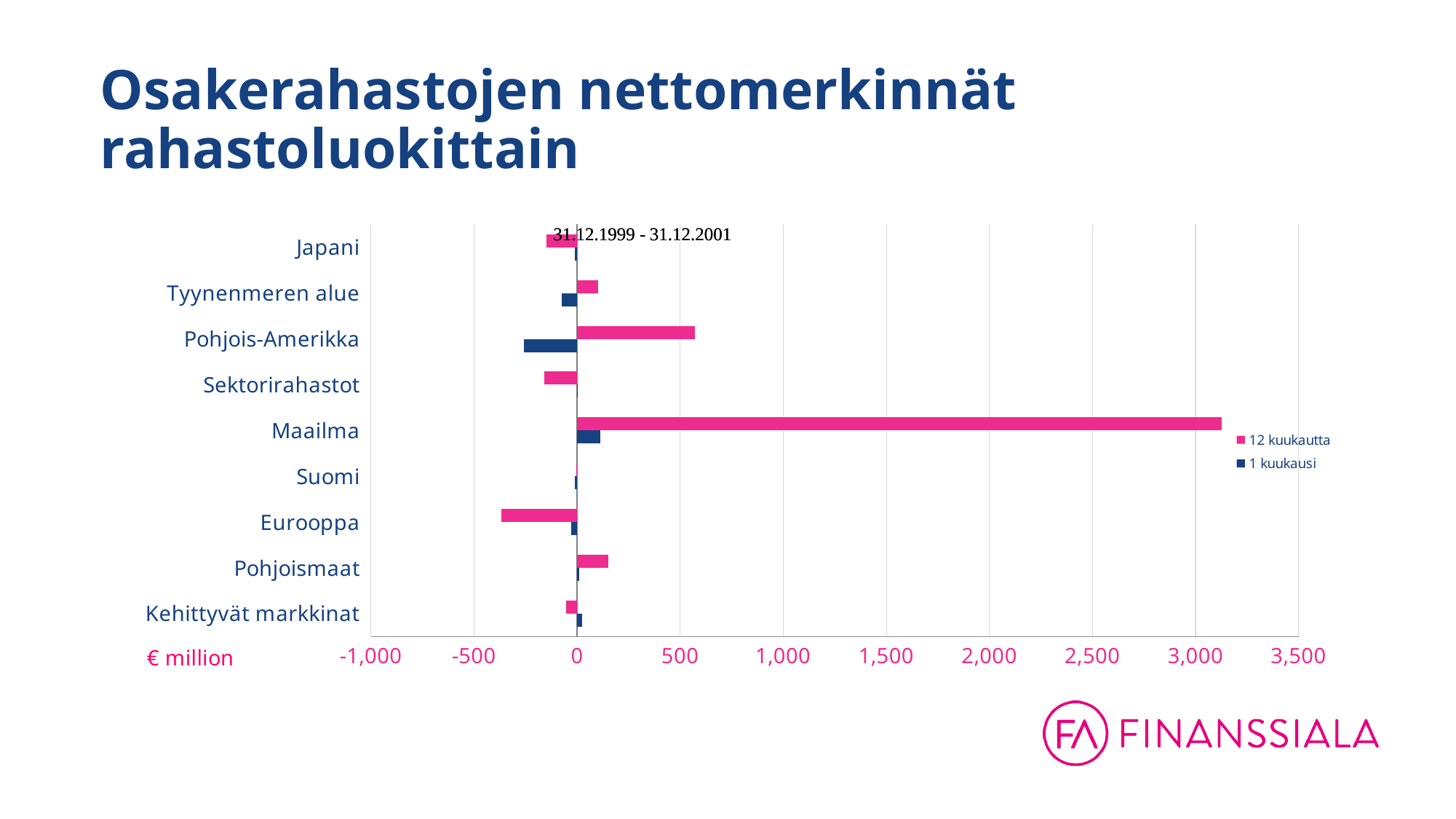
For the 12 kuukautta series, which is larger: Maailma or Pohjois-Amerikka? Maailma What kind of chart is shown on the slide? bar chart How many fund categories are listed on the vertical axis of the chart? 9 Is the 12 kuukautta value for Eurooppa greater or less than 0? less What date range is printed on the chart? 31.12.1999 - 31.12.2001 Is the 1 kuukausi value for Pohjois-Amerikka greater or less than -500? greater What unit is shown for the horizontal axis of the chart? € million Is the 12 kuukautta value for Maailma greater or less than 3,000? greater Which category has the highest value for the 12 kuukautta series? Maailma Which category has the lowest value for the 12 kuukautta series? Eurooppa How many series does the chart legend list? 2